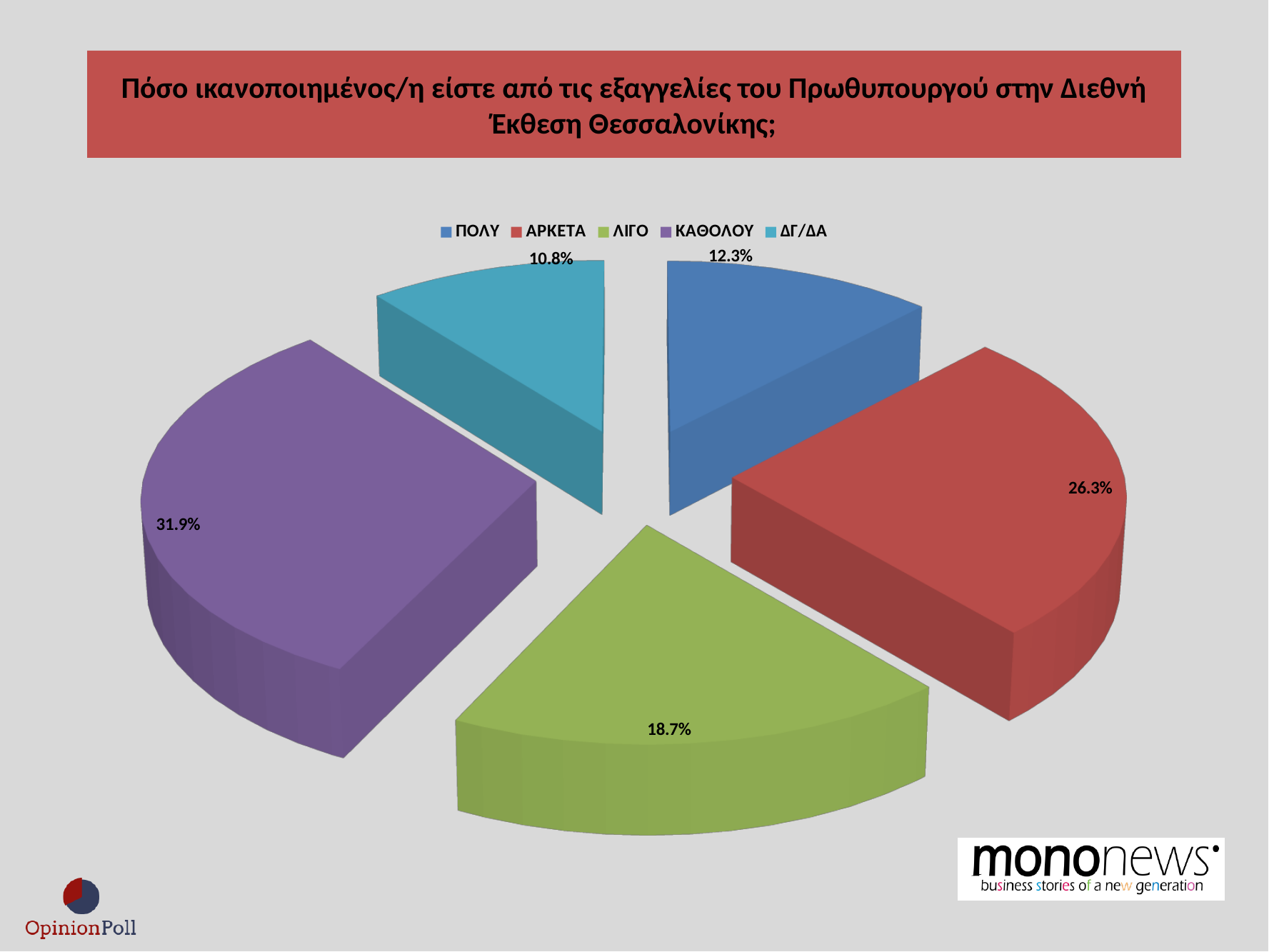
What kind of chart is shown on the slide? pie chart How many slices does the pie chart have? 5 What colour is the slice for ΚΑΘΟΛΟΥ? purple Which is larger, the value for ΛΙΓΟ or the value for ΠΟΛΥ? ΛΙΓΟ What is the value for ΑΡΚΕΤΑ? 26.3% What is the value for ΛΙΓΟ? 18.7% What is the value for ΔΓ/ΔΑ? 10.8% What is the difference between the values for ΚΑΘΟΛΟΥ and ΑΡΚΕΤΑ? 5.6% Which category has the smallest share of the pie? ΔΓ/ΔΑ What is the value for ΠΟΛΥ? 12.3% What is the value for ΚΑΘΟΛΟΥ? 31.9% Which category has the largest share of the pie? ΚΑΘΟΛΟΥ